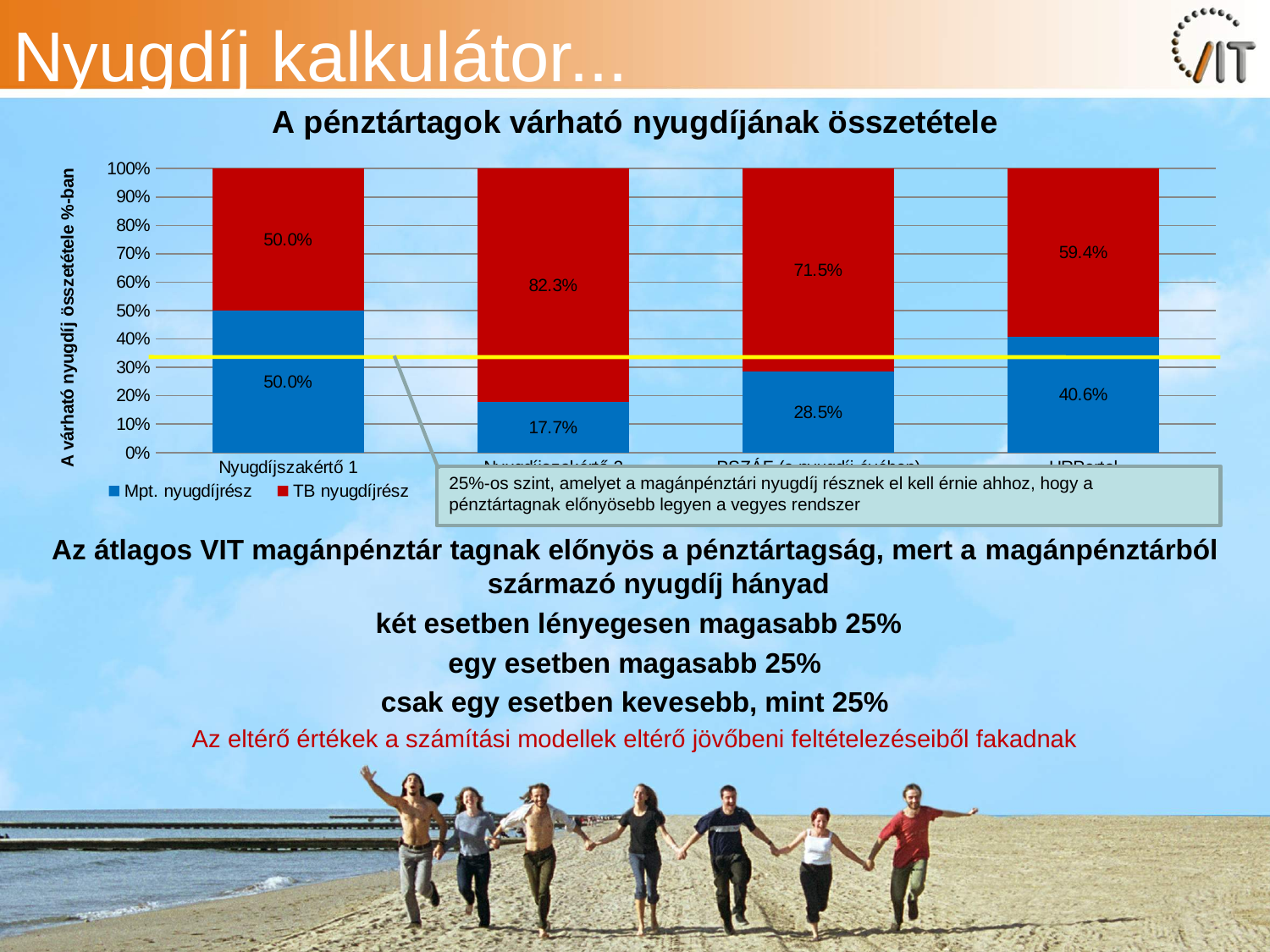
Which has a larger Mpt. nyugdíjrész share: the third bar or the fourth bar from the left? The fourth bar (40.6%) What type of chart is shown on the slide? Stacked bar chart What is the Mpt. nyugdíjrész value for the third bar from the left? 28.5% What is the TB nyugdíjrész value for the second bar from the left? 82.3% How many bars are shown in the chart? 4 What is the title of the chart? A pénztártagok várható nyugdíjának összetétele What is the Mpt. nyugdíjrész value for Nyugdíjszakértő 1? 50.0% How many series does the legend list? 2 What is the TB nyugdíjrész value for the rightmost bar? 59.4% In the second bar from the left, how many percentage points larger is the TB nyugdíjrész than the Mpt. nyugdíjrész? 64.6 percentage points Which bar has the lowest Mpt. nyugdíjrész share? The second bar from the left (17.7%) Which bar has the highest Mpt. nyugdíjrész share? Nyugdíjszakértő 1